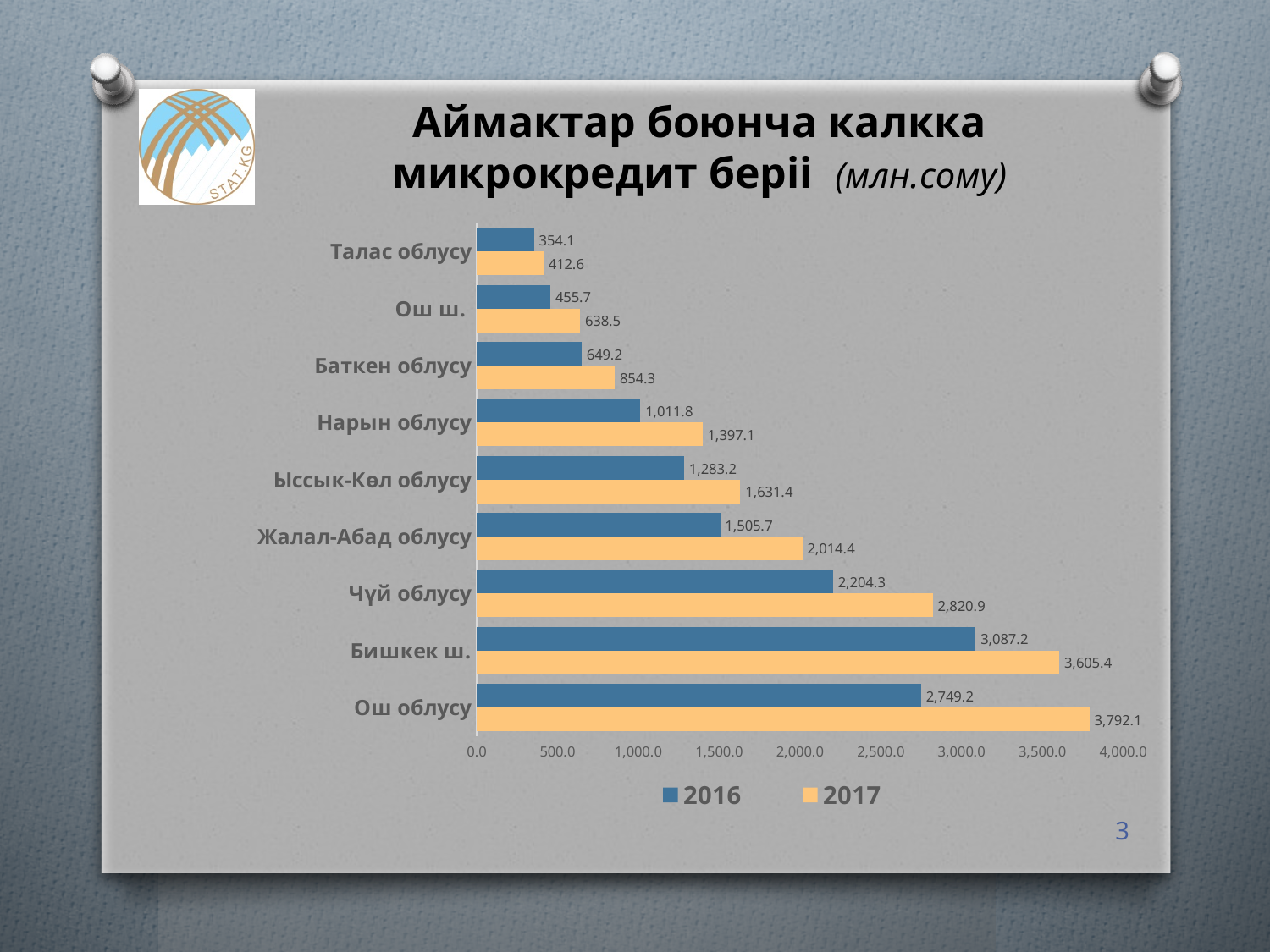
How many regions are shown on the chart? 9 What is the difference between the 2017 and 2016 values for Бишкек ш.? 518.2 Which region had the lowest value in 2016? Талас облусу Which is larger: the 2016 value for Бишкек ш. or the 2016 value for Ош облусу? Бишкек ш. Which region had the highest value in 2017? Ош облусу Which region had the highest value in 2016? Бишкек ш. What was the 2017 value for Ош ш.? 638.5 What was the 2016 value for Нарын облусу? 1,011.8 What was the 2017 value for Ош облусу? 3,792.1 How many series does the legend list? 2 What is the difference between the 2017 and 2016 values for Ош облусу? 1,042.9 What kind of chart is shown on the slide? Bar chart